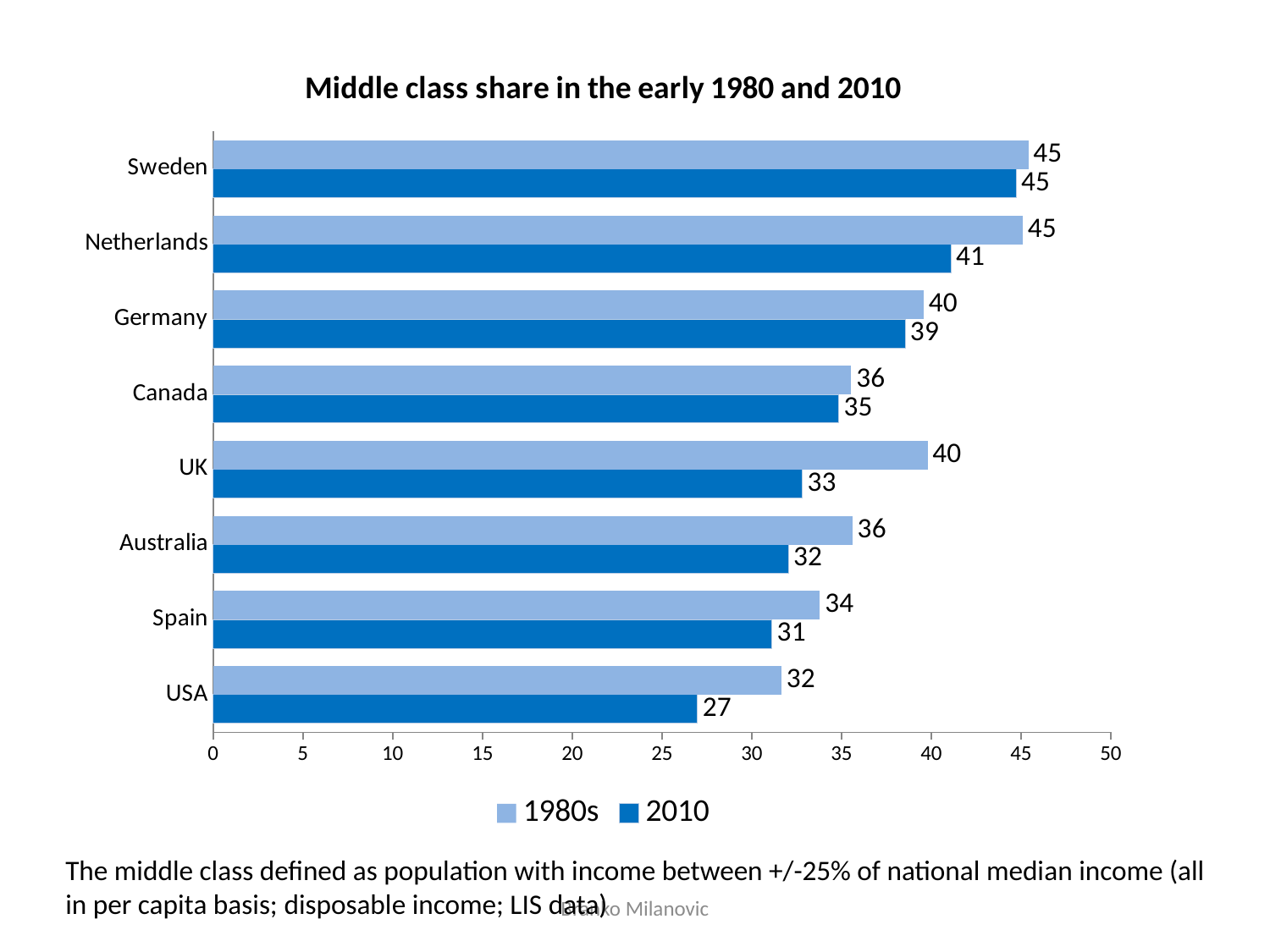
How many countries are shown on the chart? 8 What is the title of the chart? Middle class share in the early 1980 and 2010 What is the 2010 value for the USA? 27 What is the difference between the 1980s and 2010 values for the UK? 7 What kind of chart is shown on the slide? Bar chart What is the difference between the 1980s and 2010 values for the USA? 5 How many series does the legend list? 2 What is the 1980s value for the UK? 40 Which country has the lowest 2010 value? USA Which country has the highest 2010 value? Sweden What is the 2010 value for the Netherlands? 41 Which is larger, the 2010 value for Germany or the 2010 value for Canada? Germany